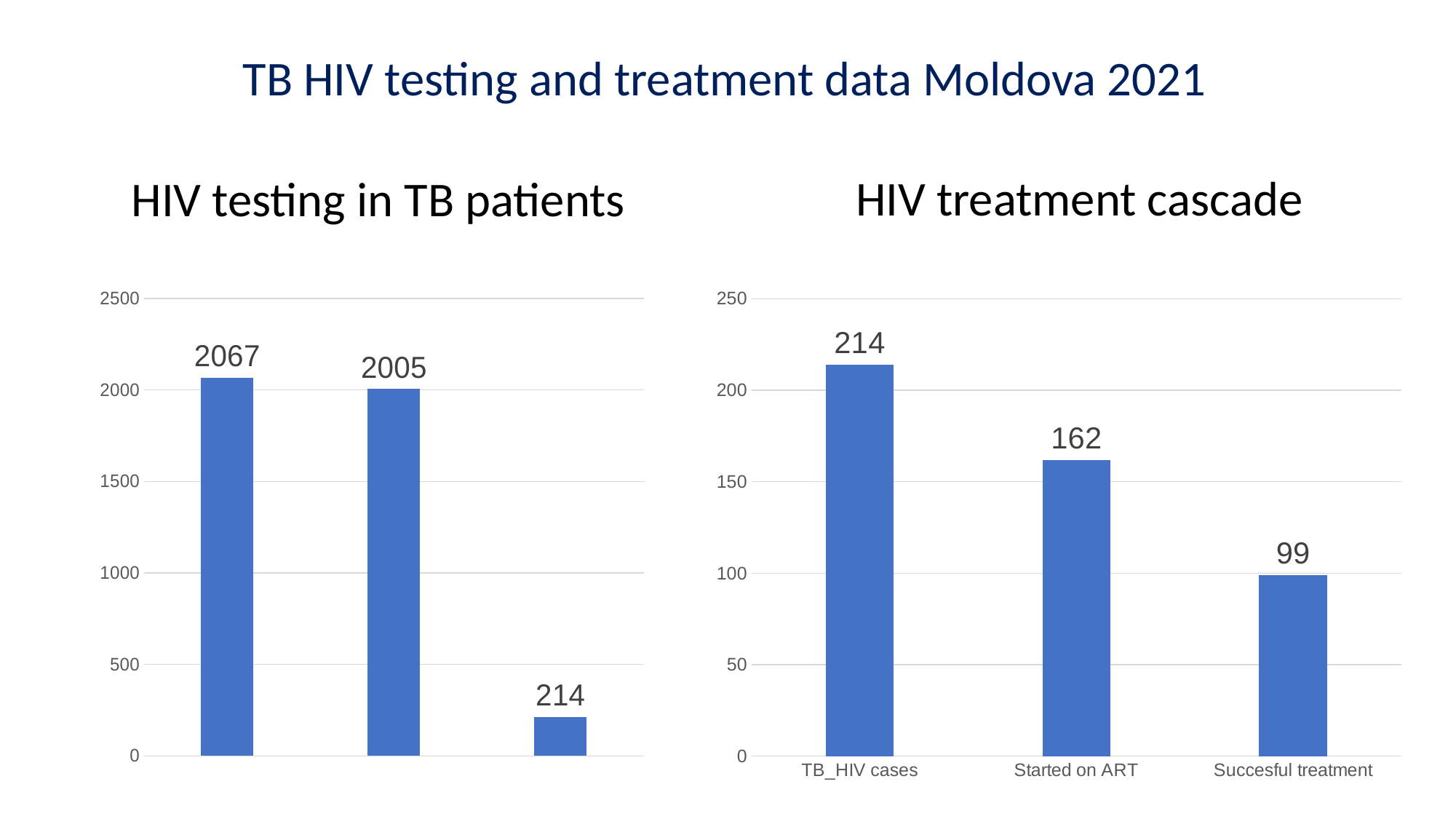
In the 'HIV treatment cascade' chart, what is the value for Succesful treatment? 99 What type of chart is the 'HIV testing in TB patients' chart? bar chart In the 'HIV treatment cascade' chart, which category has the lowest value? Succesful treatment In the 'HIV treatment cascade' chart, what is the value for Started on ART? 162 What is the value of the tallest bar in the 'HIV testing in TB patients' chart? 2067 In the 'HIV treatment cascade' chart, what is the value for TB_HIV cases? 214 In the 'HIV treatment cascade' chart, is the value for Started on ART greater or less than 150? greater What is the value of the shortest bar in the 'HIV testing in TB patients' chart? 214 In the 'HIV treatment cascade' chart, what is the difference between TB_HIV cases and Started on ART? 52 In the 'HIV treatment cascade' chart, which category has the highest value? TB_HIV cases In the 'HIV treatment cascade' chart, do the values rise or fall from left to right? fall How many bars are in the 'HIV testing in TB patients' chart? 3